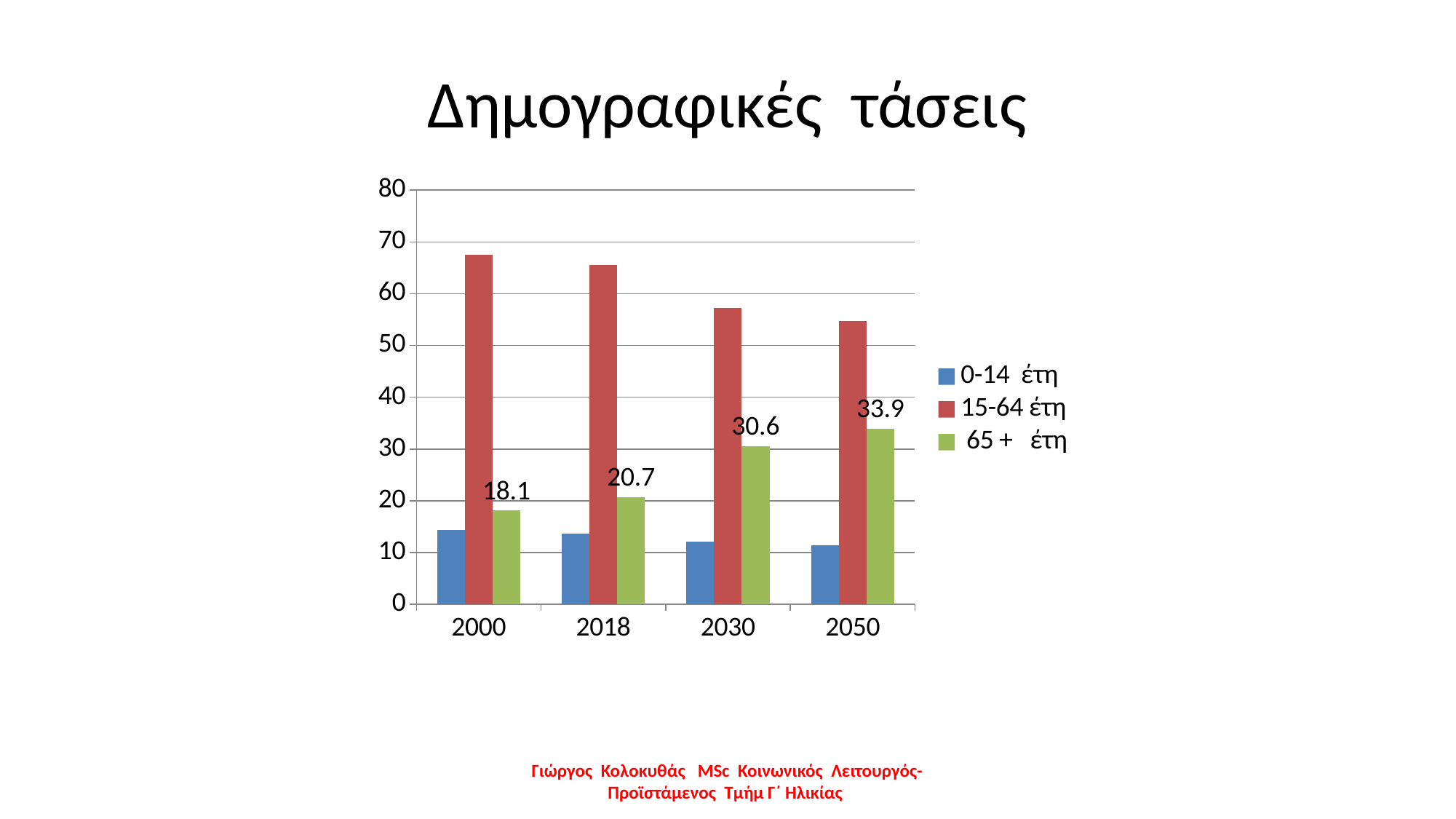
In which year is the 65+ έτη series lowest? 2000 Which is larger: the 65+ έτη value in 2030 or in 2018? 2030 What is the value for the 65+ έτη series in 2050? 33.9 How many series does the legend list? 3 What is the value for the 65+ έτη series in 2018? 20.7 What is the difference between the 65+ έτη values for 2050 and 2000? 15.8 Is the value for the 15-64 έτη series in 2000 greater or less than 60? greater Does the 15-64 έτη series rise or fall from 2000 to 2050? fall In which year is the 65+ έτη series highest? 2050 Is the value for the 0-14 έτη series in 2050 greater or less than 20? less How many years are shown on the x axis? 4 What is the value for the 65+ έτη series in 2000? 18.1